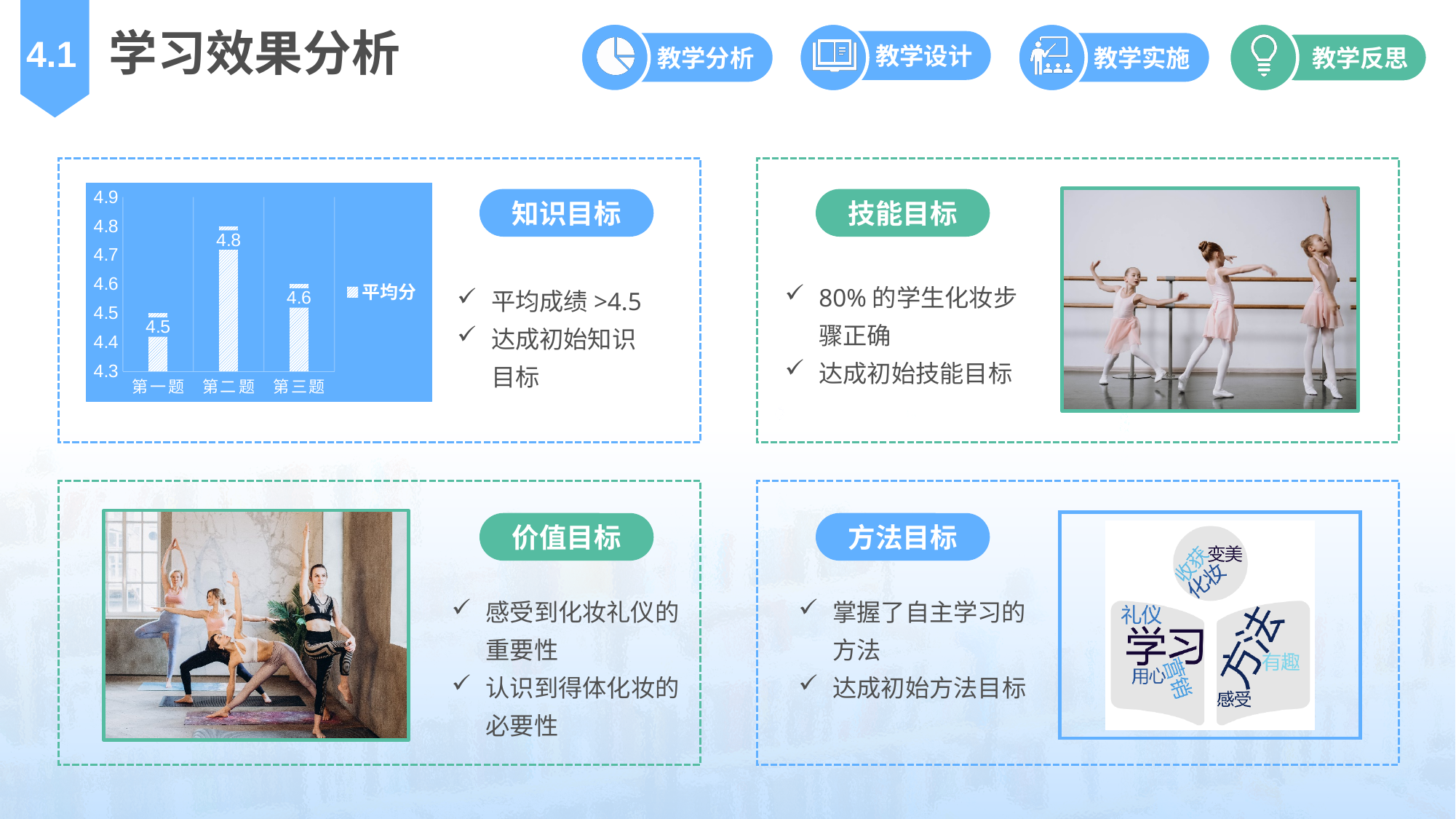
What kind of chart is shown on the slide? bar chart How many categories are shown in the bar chart? 3 Is the value for 第二题 greater or less than 4.7? greater What is the value for 第三题 in the bar chart? 4.6 Which category has the lowest value in the bar chart? 第一题 What is the value for 第一题 in the bar chart? 4.5 What is the value for 第二题 in the bar chart? 4.8 What is the difference between the values for 第二题 and 第三题? 0.2 Which is larger, the value for 第三题 or the value for 第一题? 第三题 Which category has the highest value in the bar chart? 第二题 What is the difference between the values for 第二题 and 第一题? 0.3 What series name does the chart legend show? 平均分